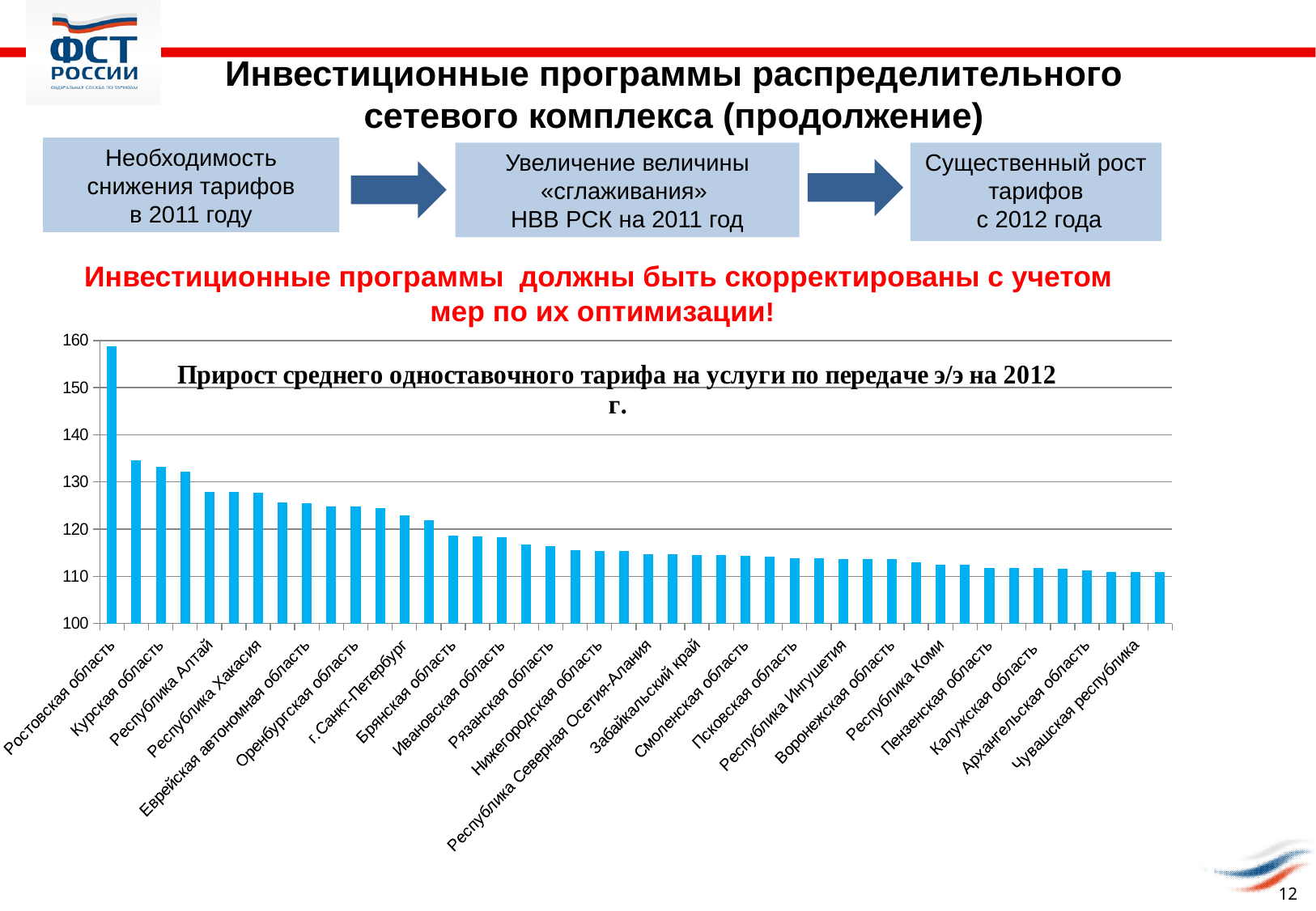
Is the value for Республика Алтай greater or less than 130? less What is the title of the chart? Прирост среднего одноставочного тарифа на услуги по передаче э/э на 2012 г. Is the value for Чувашская республика greater or less than 120? less What is the lowest value shown on the vertical axis of the chart? 100 Is the value for Курская область greater or less than 130? greater Which region has the highest value in the chart? Ростовская область What kind of chart is shown on the slide? bar chart Do the values rise or fall from left to right along the x axis? fall Which is larger, the value for Ростовская область or the value for Чувашская республика? Ростовская область